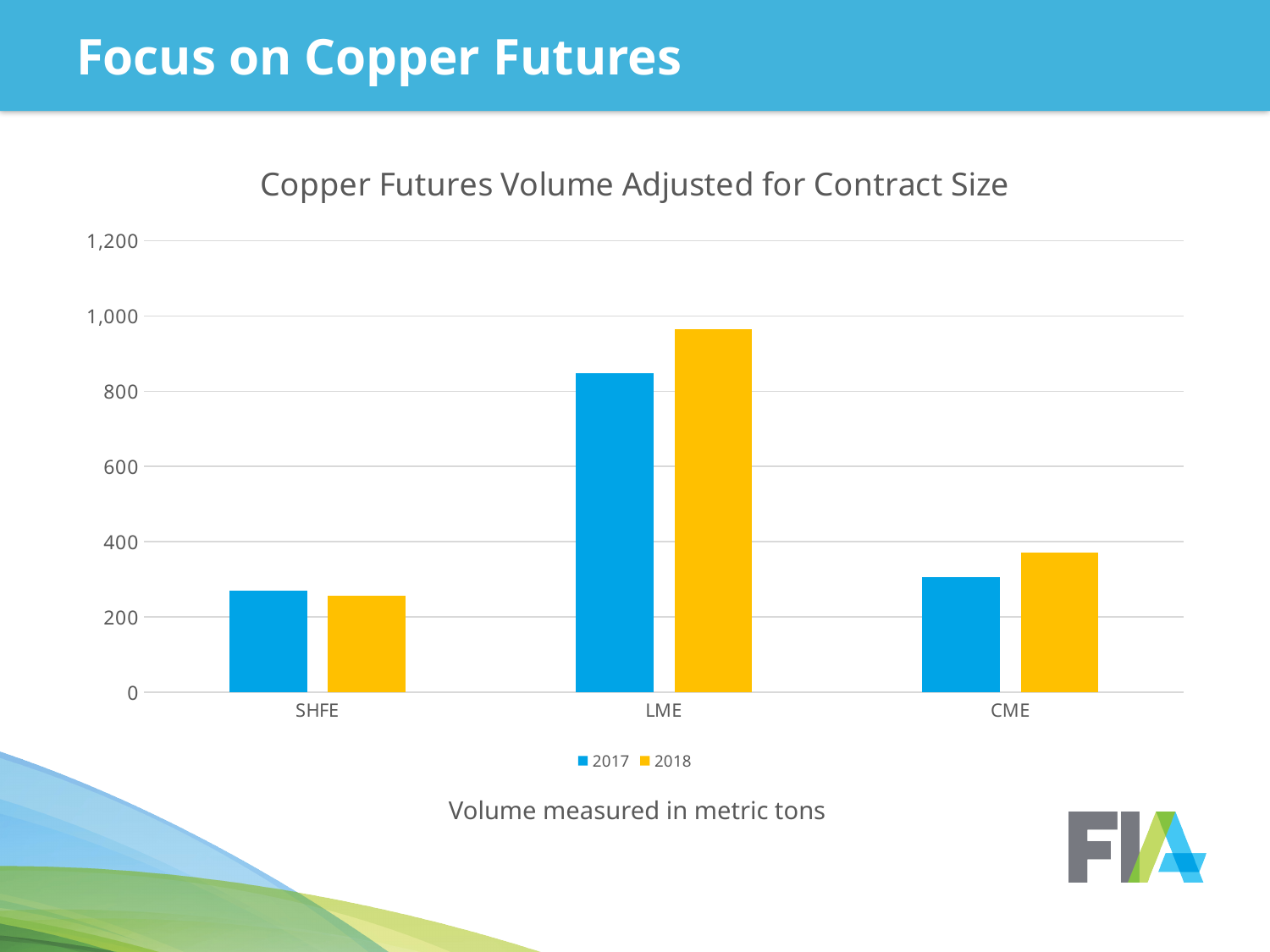
Which exchange has the lowest copper futures volume in 2017? SHFE Is the 2018 value for CME greater or less than 400? less What kind of chart is shown on the slide? Bar chart For CME, which year has the larger volume, 2017 or 2018? 2018 Is the 2017 value for LME greater or less than 800? greater How many exchanges are shown on the x axis? 3 What is the title of the chart? Copper Futures Volume Adjusted for Contract Size How many series does the legend list? 2 Which exchange has the highest copper futures volume in 2018? LME For LME, which year has the larger volume, 2017 or 2018? 2018 Is the 2018 value for LME greater or less than 1,000? less What unit is the volume measured in, according to the note below the chart? Metric tons